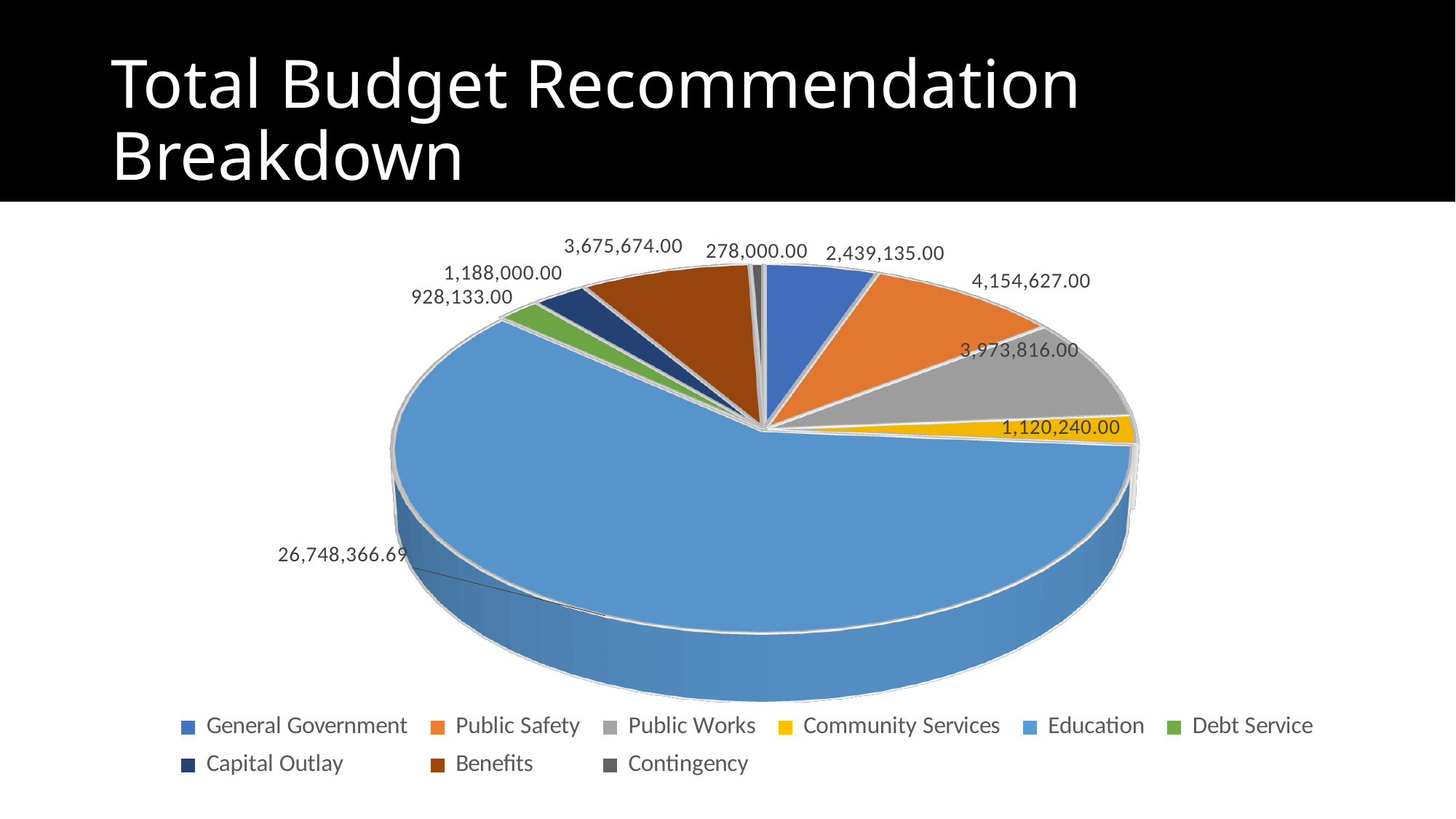
What is the value for Benefits? 3,675,674.00 Which category has the largest slice? Education Which category has the smallest slice? Contingency What is the value for Public Safety? 4,154,627.00 What is the value for Education? 26,748,366.69 Which is larger, Capital Outlay or Debt Service? Capital Outlay What is the title of the slide? Total Budget Recommendation Breakdown What is the value for Community Services? 1,120,240.00 What is the value for Contingency? 278,000.00 What is the difference between the values for Public Safety and Public Works? 180,811.00 What type of chart is shown on the slide? Pie chart How many categories does the pie chart show? 9